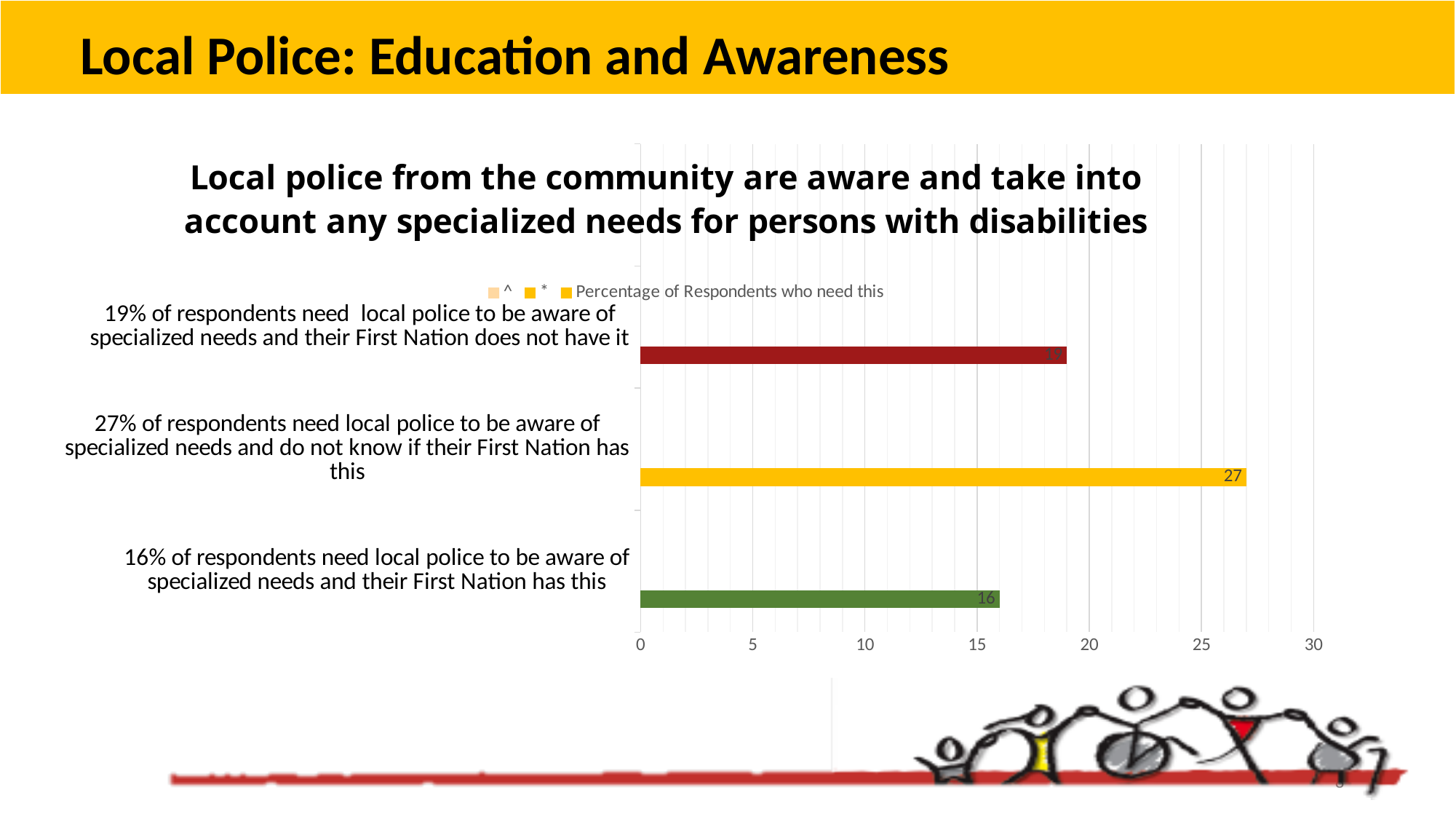
What is the value of the bar for respondents whose First Nation does not have it? 19 What type of chart is shown on the slide? bar chart What is the title of the chart? Local police from the community are aware and take into account any specialized needs for persons with disabilities What is the difference between the value for respondents who do not know if their First Nation has this and the value for respondents whose First Nation has this? 11 What is the difference between the value for respondents whose First Nation does not have it and the value for respondents whose First Nation has this? 3 How many bars are plotted in the chart? 3 What is the value of the bar for respondents who do not know if their First Nation has this? 27 Which category has the lowest value? 16% of respondents need local police to be aware of specialized needs and their First Nation has this Is the value for respondents who do not know if their First Nation has this greater or less than 25? greater Which is larger: the value for respondents whose First Nation does not have it or the value for respondents whose First Nation has this? their First Nation does not have it (19) What is the value of the bar for respondents whose First Nation has this? 16 Which category has the highest value? 27% of respondents need local police to be aware of specialized needs and do not know if their First Nation has this